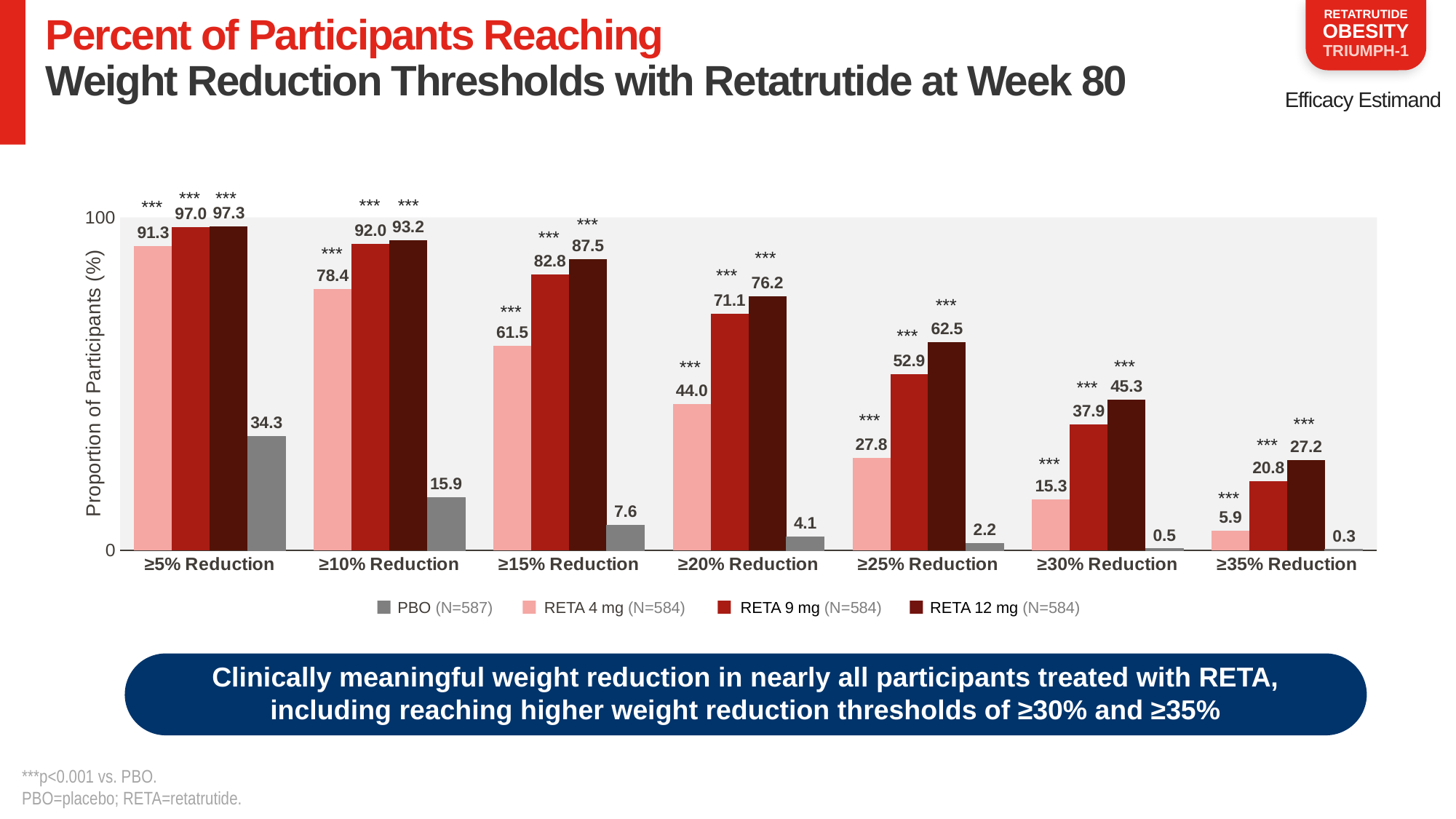
What is the value for RETA 9 mg at the ≥30% Reduction threshold? 37.9 How many series does the legend list? 4 What is the value for PBO at the ≥20% Reduction threshold? 4.1 What is the value for RETA 4 mg at the ≥15% Reduction threshold? 61.5 Do the RETA 12 mg values rise or fall as the weight reduction threshold increases along the x axis? Fall How many weight reduction threshold categories are shown on the x axis? 7 What is the value for RETA 12 mg at the ≥5% Reduction threshold? 97.3 Which series has the highest value at the ≥25% Reduction threshold? RETA 12 mg What is the difference between the RETA 12 mg and PBO values at the ≥10% Reduction threshold? 77.3 Which is larger: the RETA 9 mg value at ≥20% Reduction or the RETA 4 mg value at ≥10% Reduction? RETA 4 mg at ≥10% Reduction What kind of chart is shown on the slide? Bar chart Which series has the lowest value at the ≥35% Reduction threshold? PBO